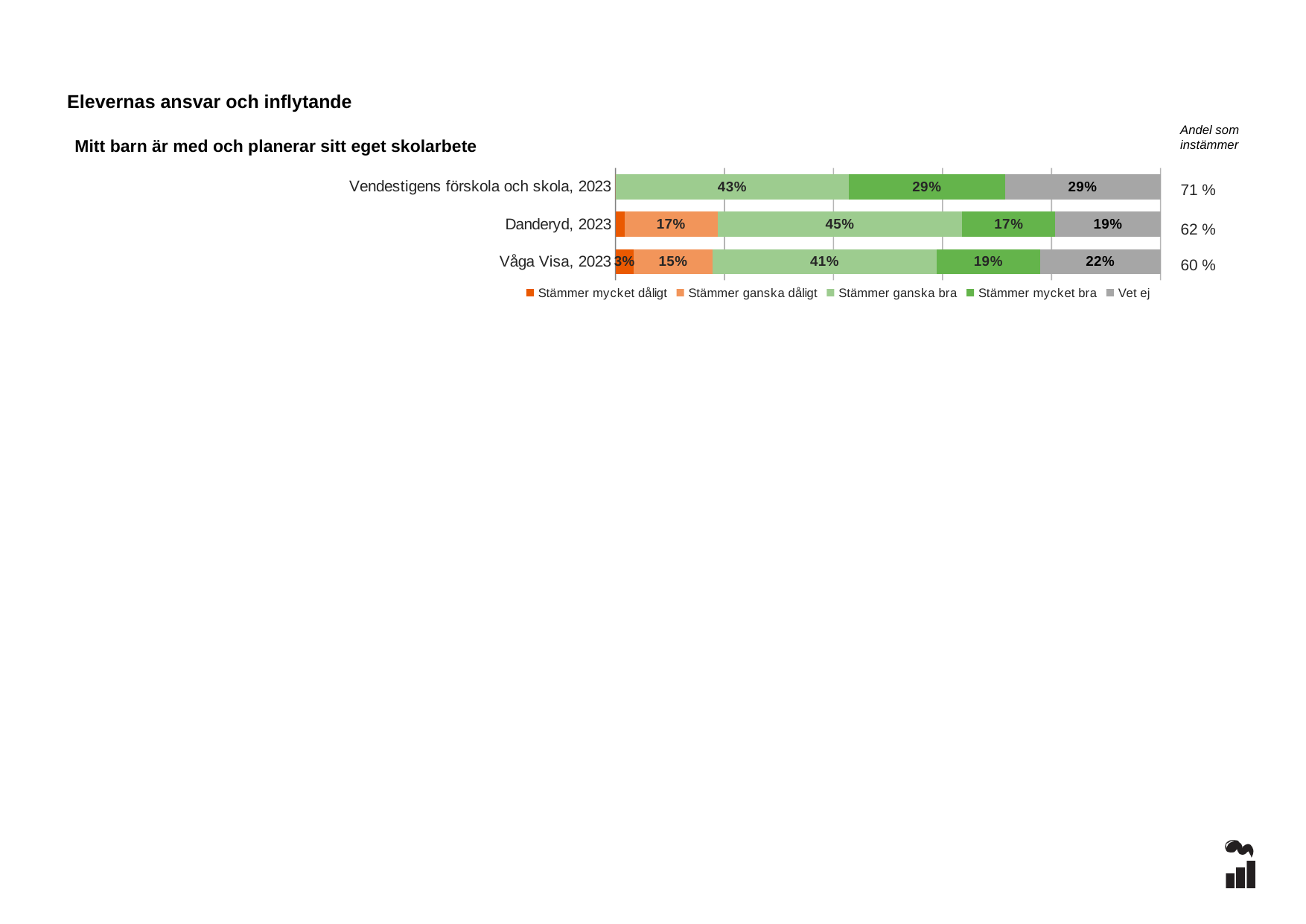
Which category has the highest "Stämmer mycket bra" value? Vendestigens förskola och skola, 2023 What is the value of "Stämmer mycket bra" for Danderyd, 2023? 17% What is the "Andel som instämmer" value shown for Vendestigens förskola och skola, 2023? 71 % How many categories (bars) are shown in the chart? 3 What kind of chart is shown on the slide? Stacked bar chart What is the value of "Vet ej" for Våga Visa, 2023? 22% What is the value of "Stämmer ganska bra" for Vendestigens förskola och skola, 2023? 43% What is the difference between the "Stämmer ganska bra" values for Danderyd, 2023 and Våga Visa, 2023? 4 percentage points Which category has the lowest "Vet ej" value? Danderyd, 2023 How many series does the legend list? 5 What is the value of "Stämmer mycket dåligt" for Våga Visa, 2023? 3% Which is larger: the "Stämmer ganska dåligt" value for Danderyd, 2023 or for Våga Visa, 2023? Danderyd, 2023